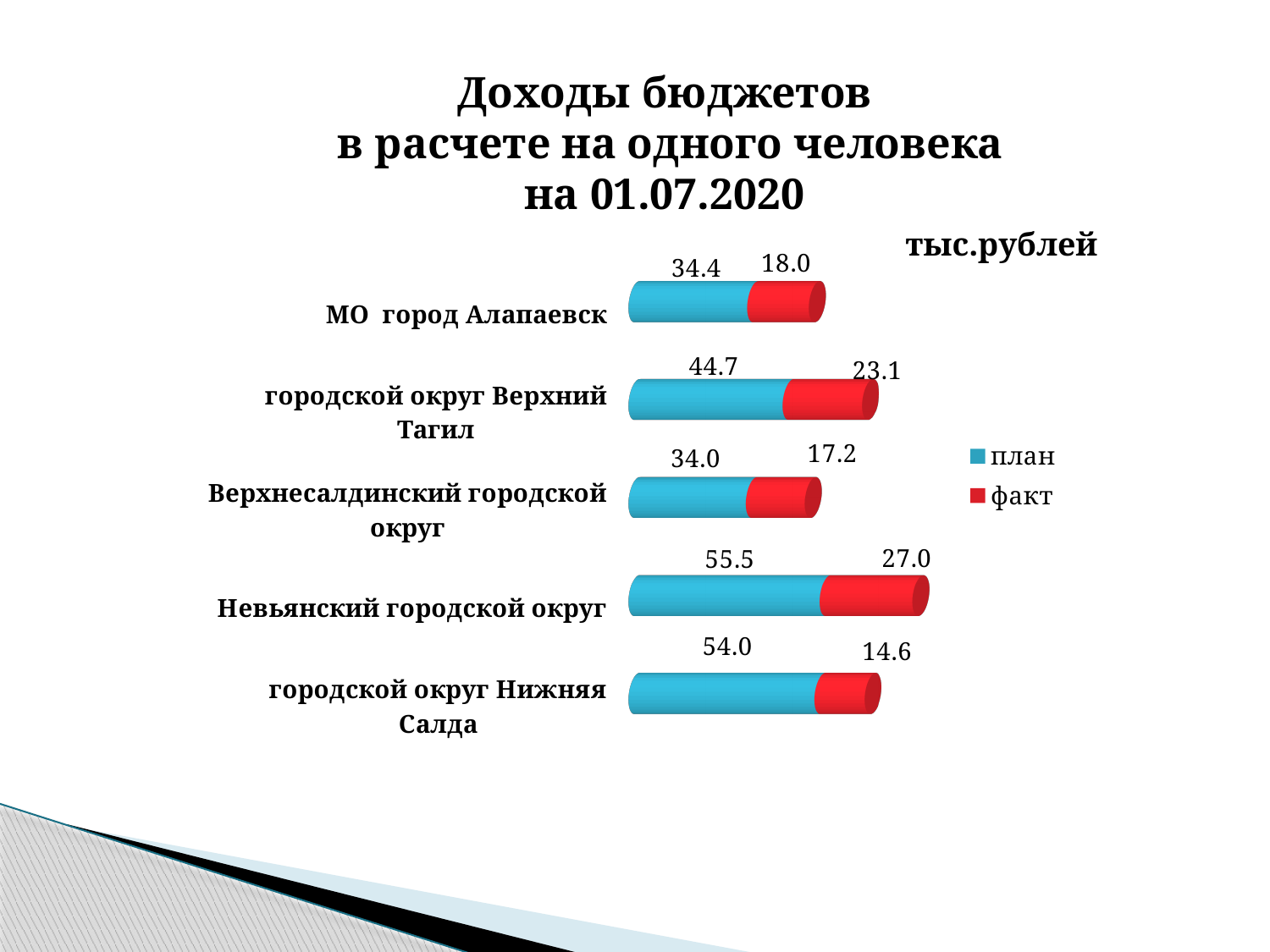
Which category has the lowest факт value? городской округ Нижняя Салда What is the план value for Невьянский городской округ? 55.5 Which category has the highest план value? Невьянский городской округ What unit is stated for the values in the chart? тыс.рублей What is the total of the stacked bar for МО город Алапаевск? 52.4 What is the difference between the план and факт values for городской округ Верхний Тагил? 21.6 What is the факт value for городской округ Нижняя Салда? 14.6 How many categories are shown in the chart? 5 Which is larger, the факт value for Невьянский городской округ or the факт value for Верхнесалдинский городской округ? Невьянский городской округ How many series does the legend list? 2 What kind of chart is shown on the slide? bar chart What is the факт value for МО город Алапаевск? 18.0